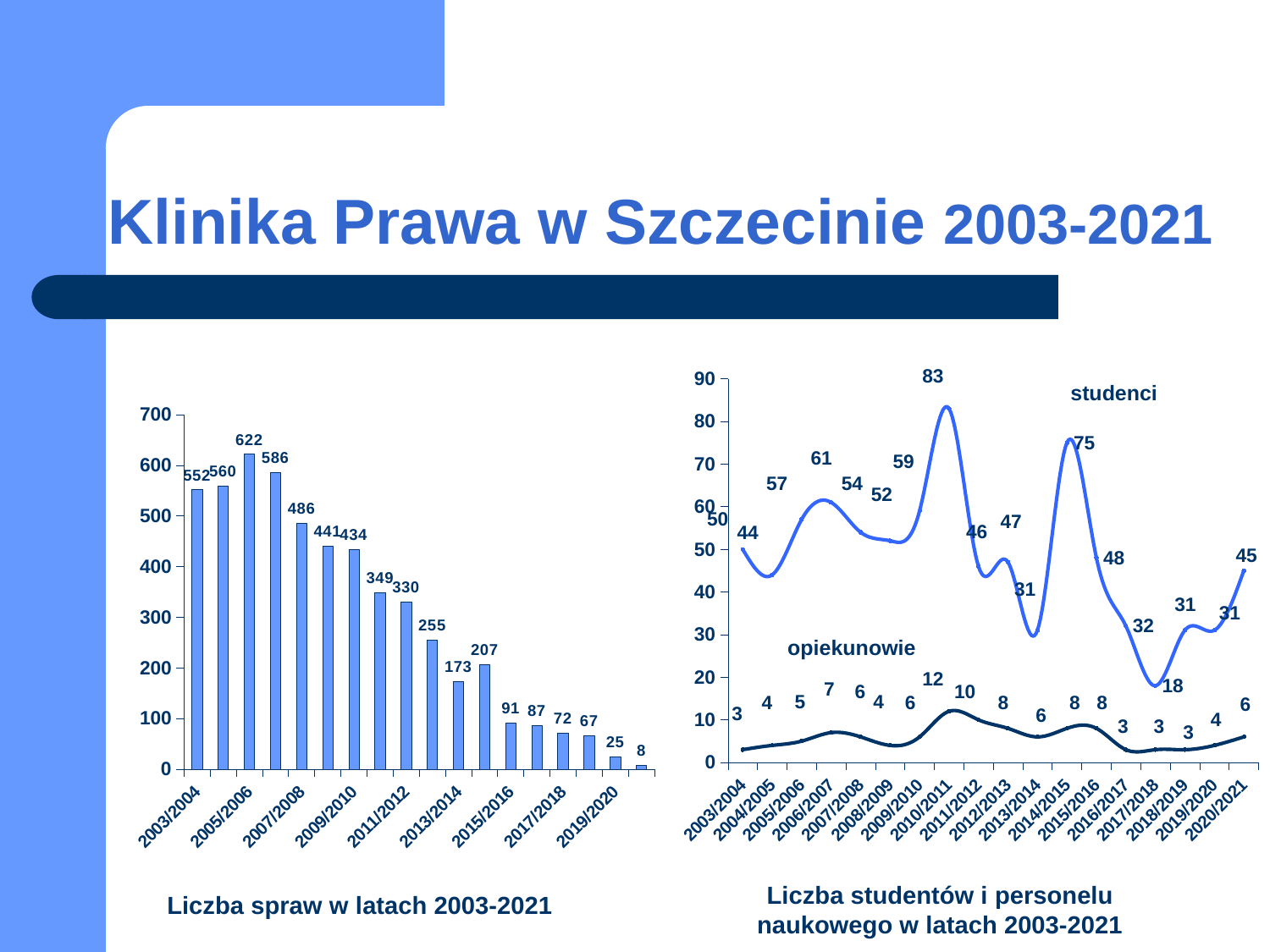
How many series are plotted in the right chart 'Liczba studentów i personelu naukowego w latach 2003-2021'? 2 In the left chart 'Liczba spraw w latach 2003-2021', what is the lowest value shown? 8 In the left chart 'Liczba spraw w latach 2003-2021', what is the highest value shown? 622 In the right chart 'Liczba studentów i personelu naukowego w latach 2003-2021', what is the highest value of the 'opiekunowie' series? 12 How many bars are plotted in the left chart 'Liczba spraw w latach 2003-2021'? 18 In the right chart 'Liczba studentów i personelu naukowego w latach 2003-2021', what is the highest value of the 'studenci' series? 83 In the right chart 'Liczba studentów i personelu naukowego w latach 2003-2021', what is the value of the 'studenci' series for 2020/2021? 45 In the left chart 'Liczba spraw w latach 2003-2021', what is the difference between the value for 2005/2006 and the value for 2003/2004? 70 In the left chart 'Liczba spraw w latach 2003-2021', do the values generally rise or fall from 2005/2006 onwards? fall What kind of chart is the right chart, 'Liczba studentów i personelu naukowego w latach 2003-2021'? line chart What kind of chart is the left chart, 'Liczba spraw w latach 2003-2021'? bar chart In the left chart 'Liczba spraw w latach 2003-2021', what is the value for 2003/2004? 552